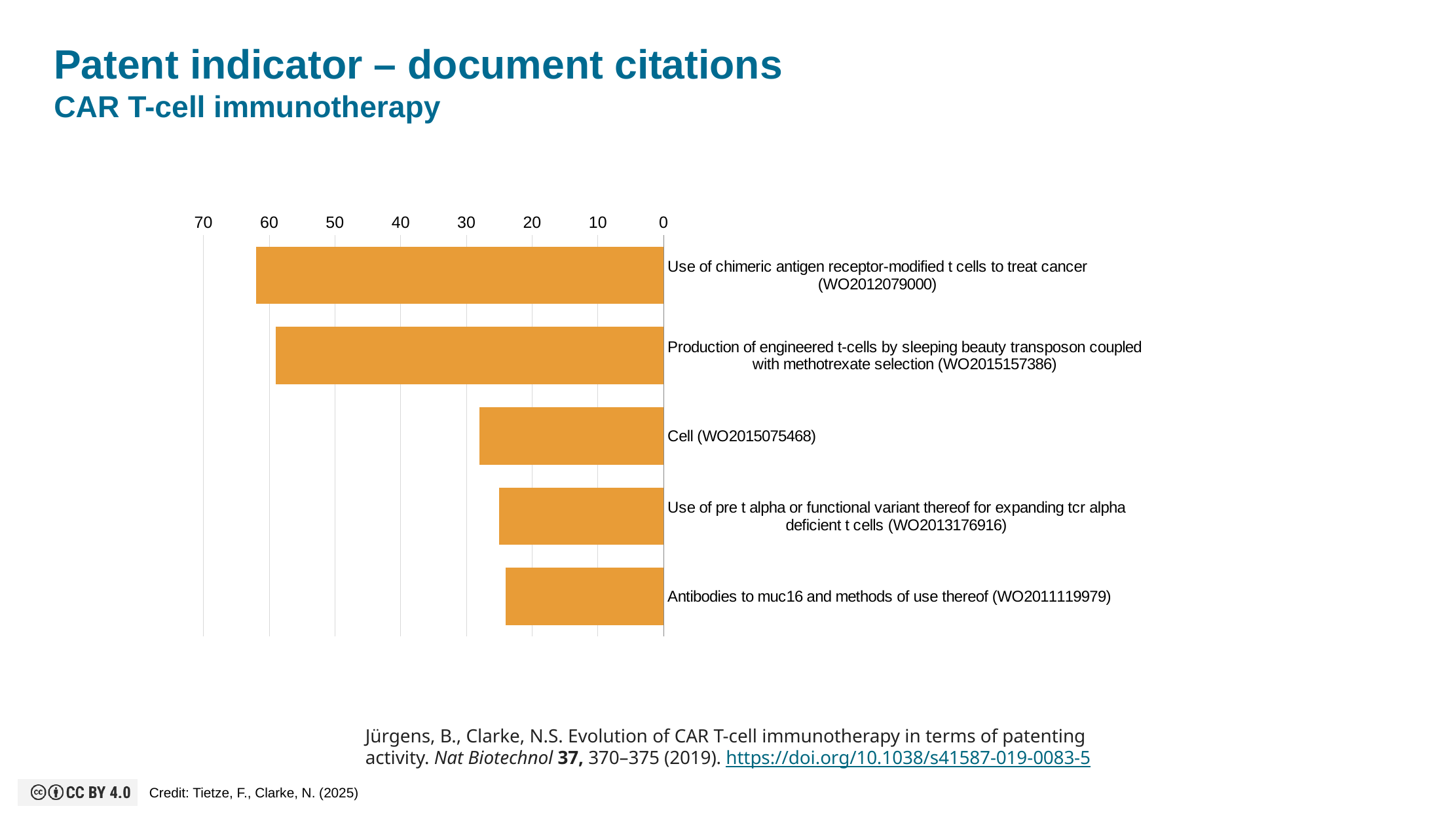
How many patent documents (bars) are shown in the chart? 5 Do the bar values increase or decrease from the top of the chart to the bottom? Decrease What kind of chart is shown on the slide? Bar chart Is the value for Antibodies to muc16 and methods of use thereof (WO2011119979) greater or less than 30? less Which has more citations: Use of chimeric antigen receptor-modified t cells to treat cancer (WO2012079000) or Cell (WO2015075468)? Use of chimeric antigen receptor-modified t cells to treat cancer (WO2012079000) Which has more citations: Cell (WO2015075468) or Antibodies to muc16 and methods of use thereof (WO2011119979)? Cell (WO2015075468) What is the highest value shown on the chart's axis? 70 Which patent document has the highest number of citations? Use of chimeric antigen receptor-modified t cells to treat cancer (WO2012079000) Is the value for Use of pre t alpha or functional variant thereof for expanding tcr alpha deficient t cells (WO2013176916) greater or less than 20? greater Is the value for Production of engineered t-cells by sleeping beauty transposon coupled with methotrexate selection (WO2015157386) greater or less than 50? greater